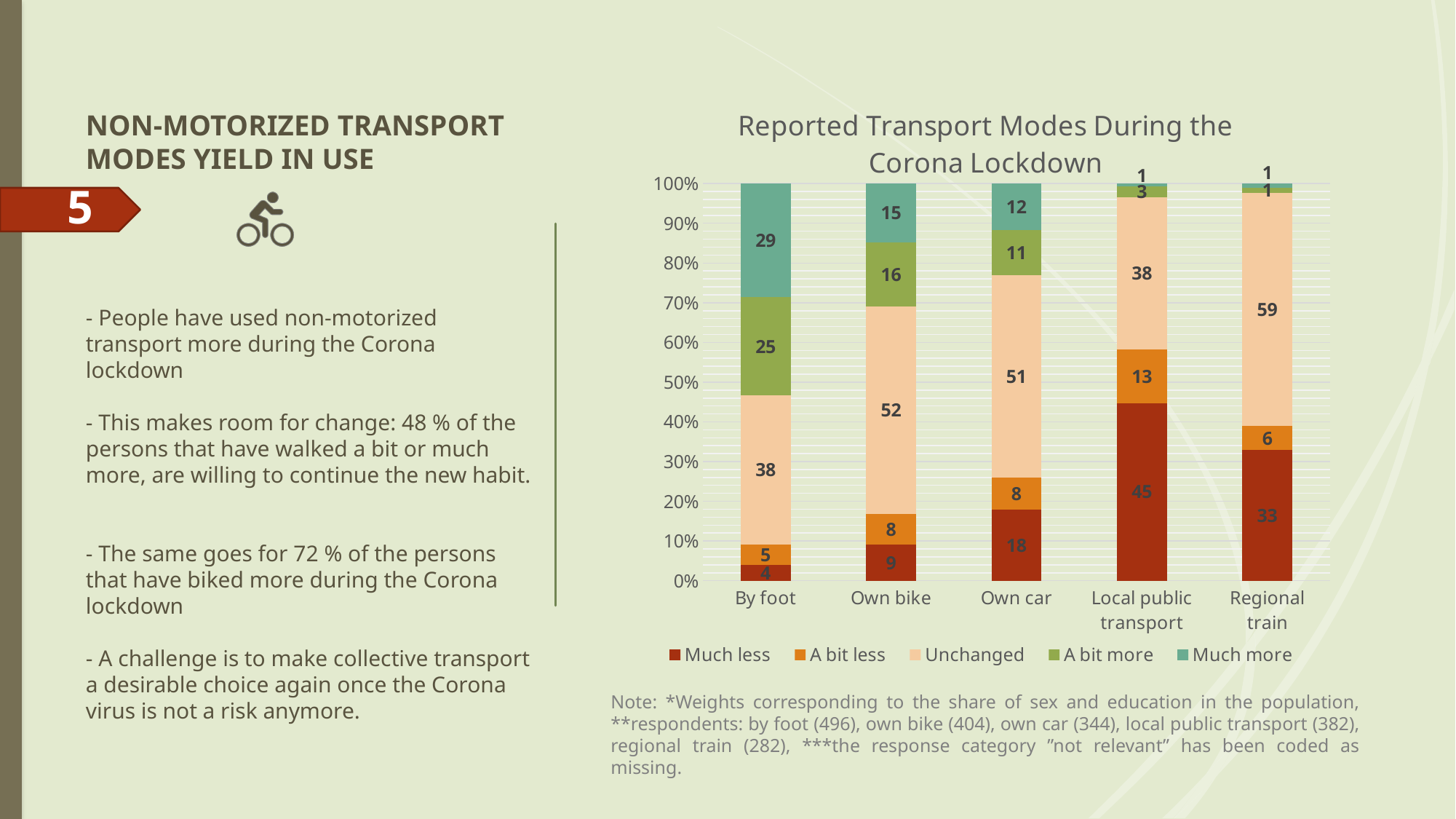
What is the title of the chart? Reported Transport Modes During the Corona Lockdown Which category has the highest value for "Much less"? Local public transport How many transport mode categories are shown on the x axis? 5 What is the value for "Much less" in the Local public transport category? 45 What is the value for "A bit more" in the Own bike category? 16 How many series does the legend list? 5 What kind of chart is shown on the slide? Stacked bar chart Which is larger: the "A bit more" value for By foot or for Own car? By foot What is the value for "Unchanged" in the Regional train category? 59 What is the difference between the "Unchanged" values for Own bike and Own car? 1 Which category has the lowest value for "Much more"? Local public transport and Regional train (both 1) What is the value for "Much more" in the By foot category? 29